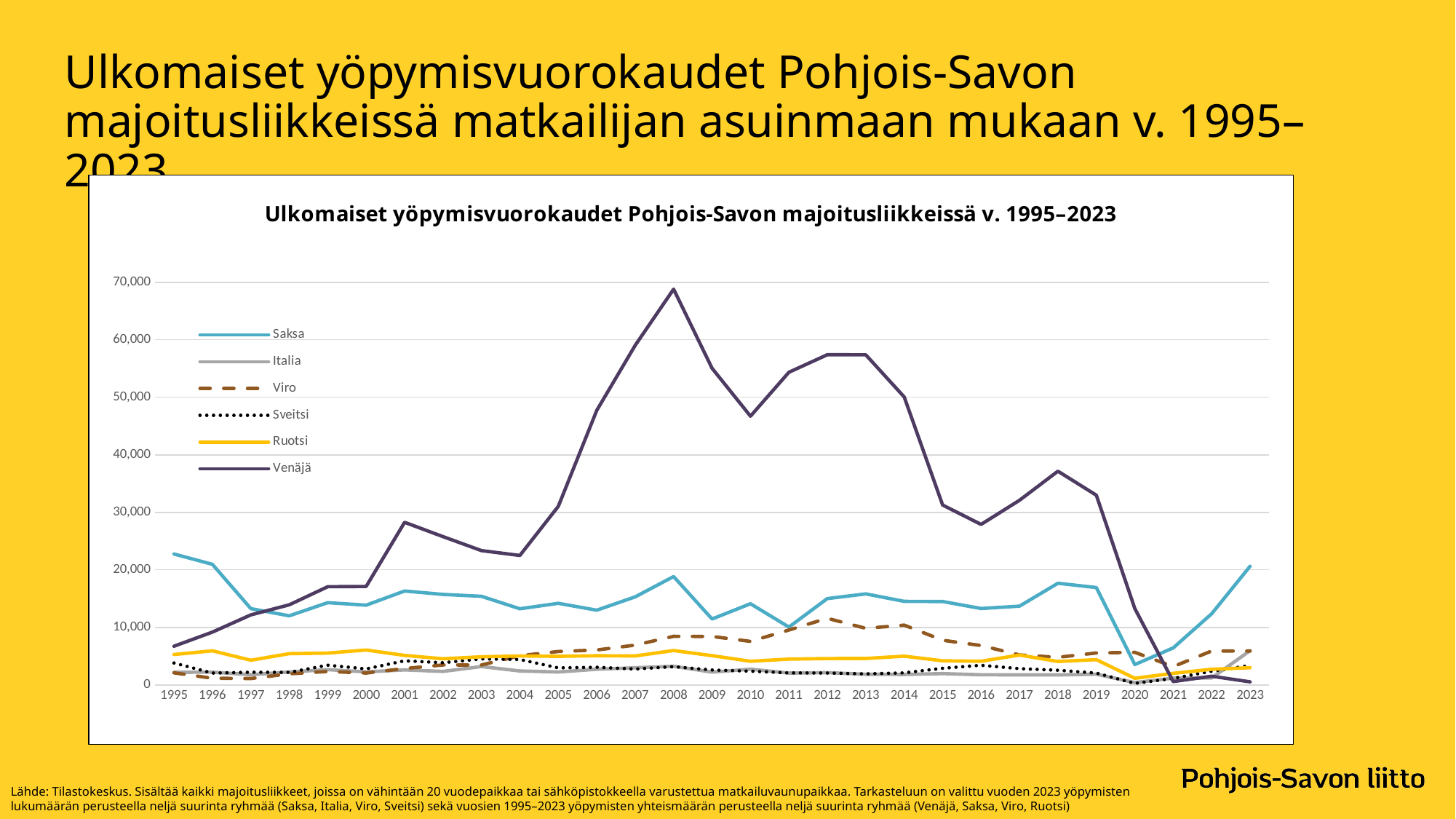
What kind of chart is shown on the slide? line chart Is the value for Saksa in 2020 greater or less than 10,000? less How many series does the chart's legend list? 6 In 2023, which is larger: the value for Saksa or the value for Venäjä? Saksa Which series is drawn with a dotted black line in the legend? Sveitsi How many years are plotted along the x axis of the chart? 29 In which year does the Venäjä series reach its peak? 2008 Does the Venäjä series rise or fall between 2018 and 2021? fall Which series reaches the highest value anywhere on the chart? Venäjä Is the value for Venäjä in 1995 greater or less than 10,000? less Is the value for Venäjä in 2008 greater or less than 60,000? greater Does the Saksa series rise or fall between 2020 and 2023? rise